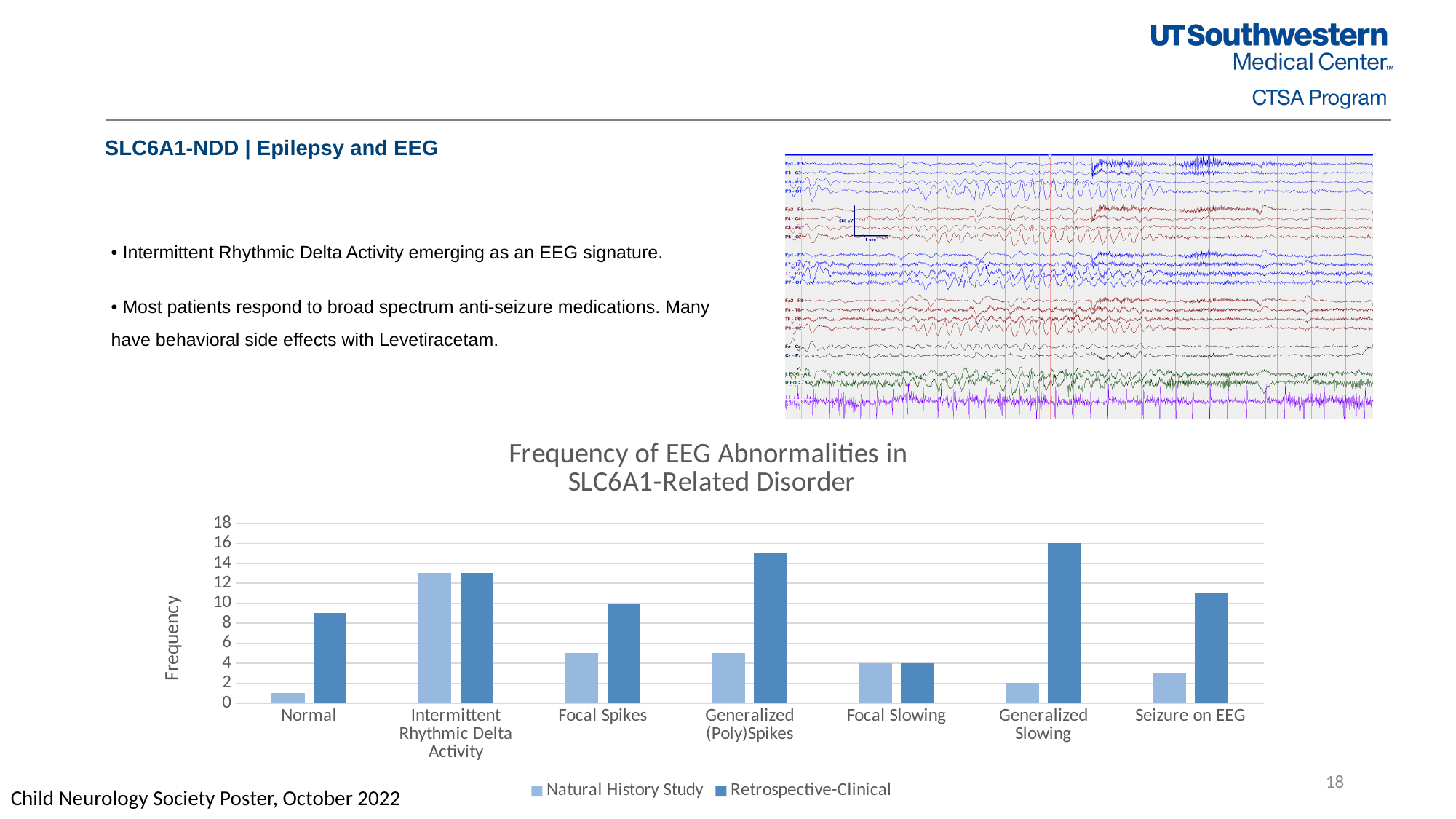
Which category has the lowest Natural History Study frequency? Normal Which category has the highest Natural History Study frequency? Intermittent Rhythmic Delta Activity What is the label on the y axis of the EEG abnormalities chart? Frequency What is the Natural History Study frequency for Focal Slowing? 4 What type of chart is shown under the title 'Frequency of EEG Abnormalities in SLC6A1-Related Disorder'? Bar chart For Focal Spikes, which series has the larger frequency: Natural History Study or Retrospective-Clinical? Retrospective-Clinical Is the Retrospective-Clinical value for Generalized (Poly)Spikes greater or less than 12? greater What is the Natural History Study frequency for Generalized Slowing? 2 How many series does the legend of the EEG abnormalities chart list? 2 What is the Retrospective-Clinical frequency for Focal Spikes? 10 How many EEG abnormality categories are shown on the x axis of the chart? 7 What is the Retrospective-Clinical frequency for Generalized Slowing? 16